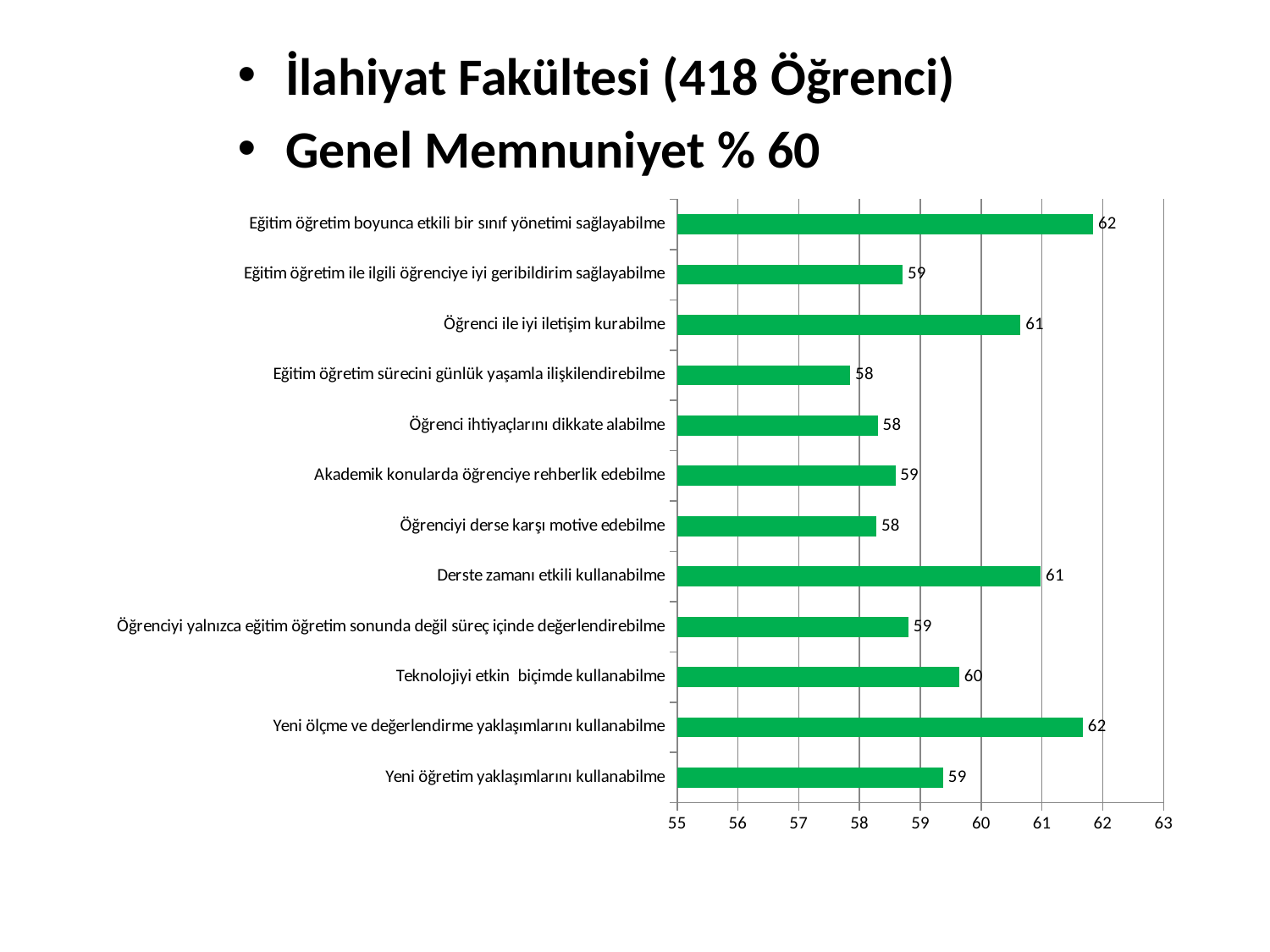
What is the value for "Öğrenci ile iyi iletişim kurabilme"? 61 How many categories are shown in the chart? 12 What is the value for "Yeni ölçme ve değerlendirme yaklaşımlarını kullanabilme"? 62 Is the value for "Teknolojiyi etkin biçimde kullanabilme" greater or less than 59? greater Which has a larger value: "Öğrenci ile iyi iletişim kurabilme" or "Öğrenci ihtiyaçlarını dikkate alabilme"? Öğrenci ile iyi iletişim kurabilme What kind of chart is shown on the slide? bar chart What is the difference between the values for "Eğitim öğretim boyunca etkili bir sınıf yönetimi sağlayabilme" and "Öğrenciyi derse karşı motive edebilme"? 4 What is the value for "Derste zamanı etkili kullanabilme"? 61 What is the lowest value shown on the horizontal axis of the chart? 55 What is the value for "Teknolojiyi etkin biçimde kullanabilme"? 60 What is the value for "Eğitim öğretim sürecini günlük yaşamla ilişkilendirebilme"? 58 Which has a larger value: "Yeni ölçme ve değerlendirme yaklaşımlarını kullanabilme" or "Yeni öğretim yaklaşımlarını kullanabilme"? Yeni ölçme ve değerlendirme yaklaşımlarını kullanabilme